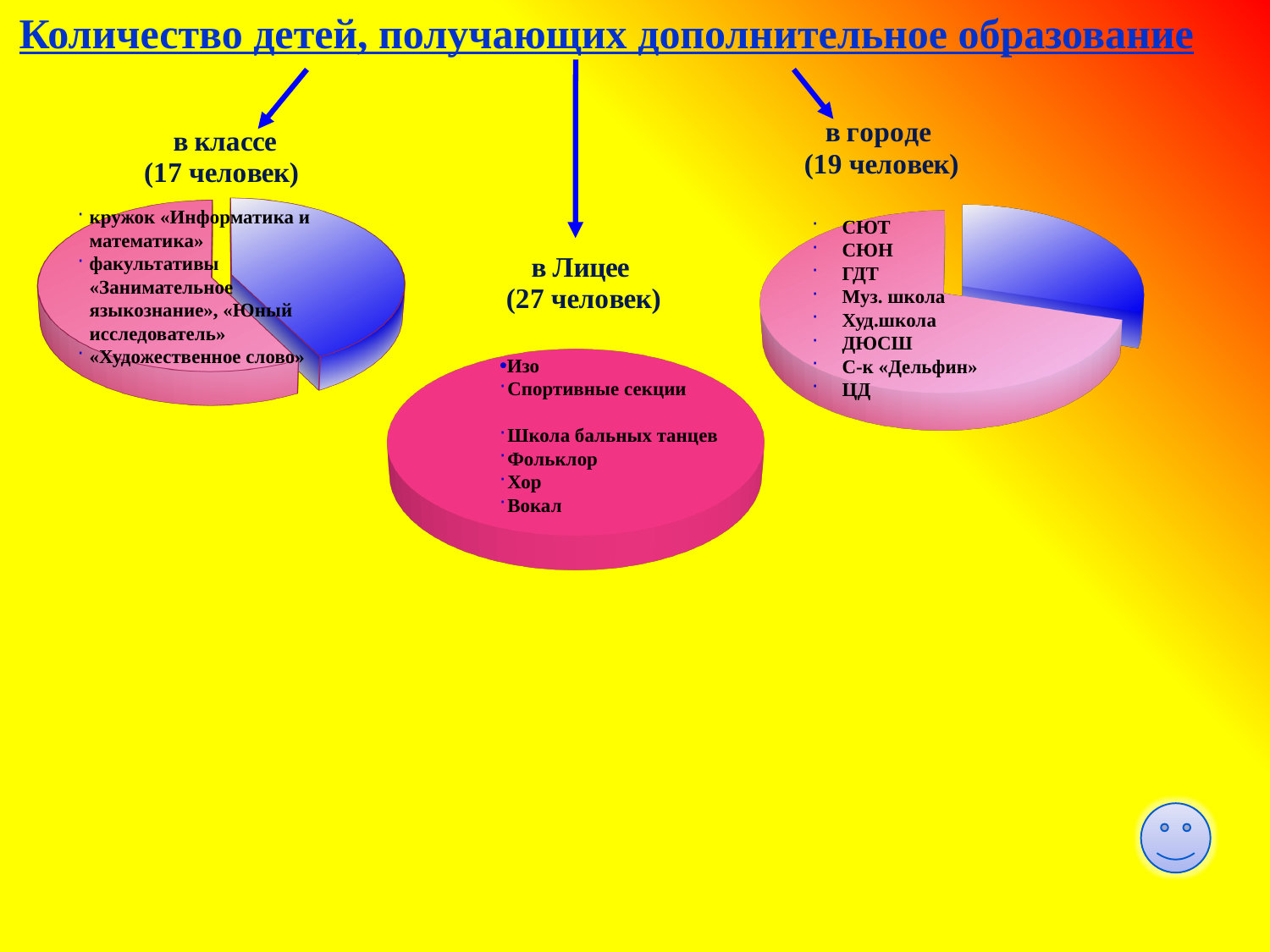
What kind of chart is used for the 'в классе (17 человек)' data on the left of the slide? pie chart How many pie charts are shown on the slide? 3 What is the title of the slide above the charts? Количество детей, получающих дополнительное образование How many people does the heading above the middle pie chart ('в Лицее') state? 27 человек What kind of chart is used for the 'в городе (19 человек)' data on the right of the slide? pie chart How many slices does the right pie chart ('в городе') have? 2 How many slices does the left pie chart ('в классе') have? 2 In the right pie chart ('в городе'), which colour slice is the smallest? blue